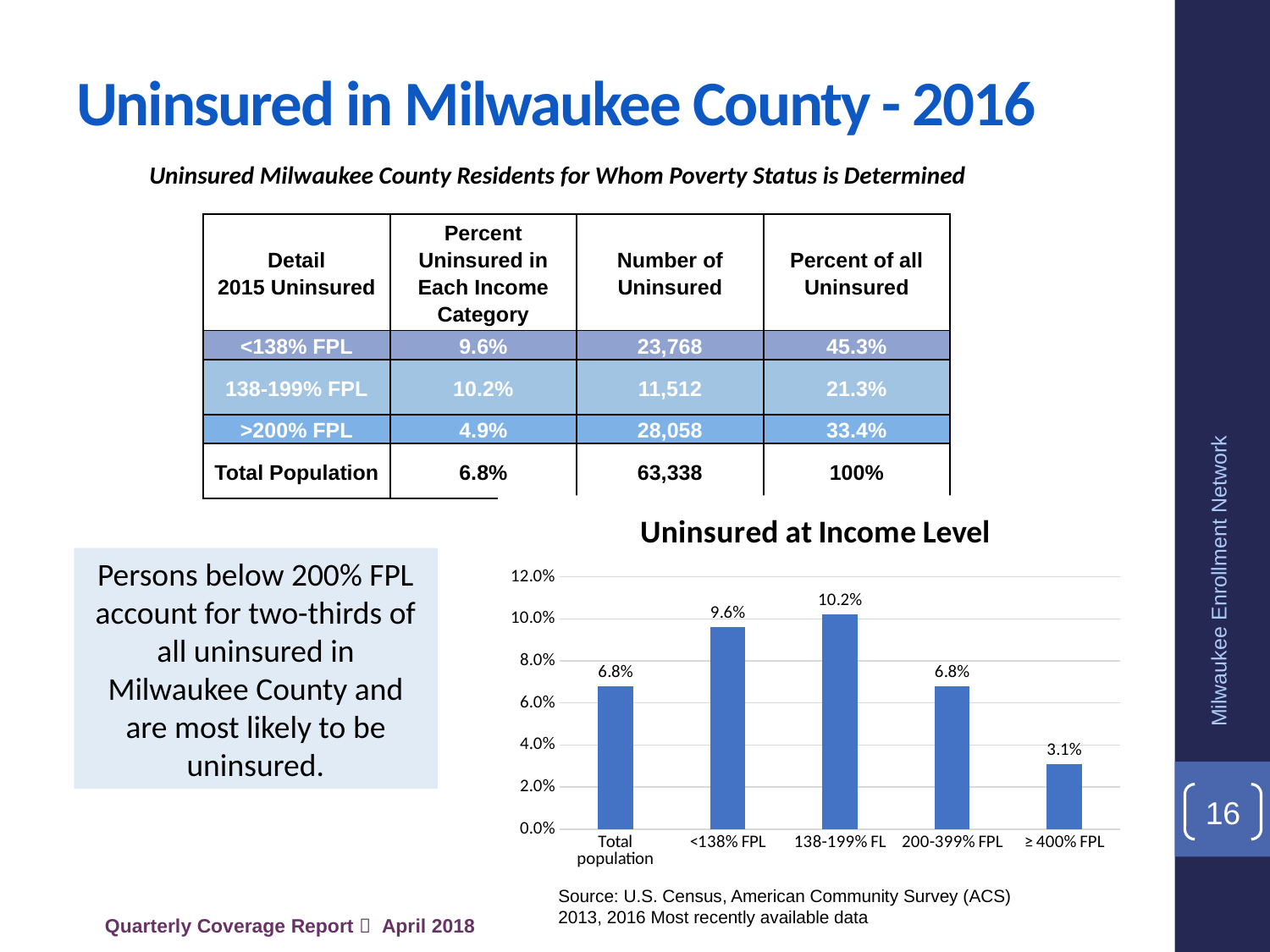
Which category has the highest value in the Uninsured at Income Level chart? 138-199% FL Is the value for 138-199% FL greater or less than 8.0% in the Uninsured at Income Level chart? greater What is the value for ≥ 400% FPL in the Uninsured at Income Level chart? 3.1% Which category has the lowest value in the Uninsured at Income Level chart? ≥ 400% FPL What is the value for Total population in the Uninsured at Income Level chart? 6.8% What kind of chart is the Uninsured at Income Level chart? bar chart What is the value for <138% FPL in the Uninsured at Income Level chart? 9.6% What is the title of the chart on the slide? Uninsured at Income Level What is the maximum value shown on the y axis of the Uninsured at Income Level chart? 12.0% What is the difference between the values for 138-199% FL and ≥ 400% FPL in the Uninsured at Income Level chart? 7.1% Which is larger in the Uninsured at Income Level chart: the value for <138% FPL or the value for 200-399% FPL? <138% FPL How many categories are shown in the Uninsured at Income Level chart? 5